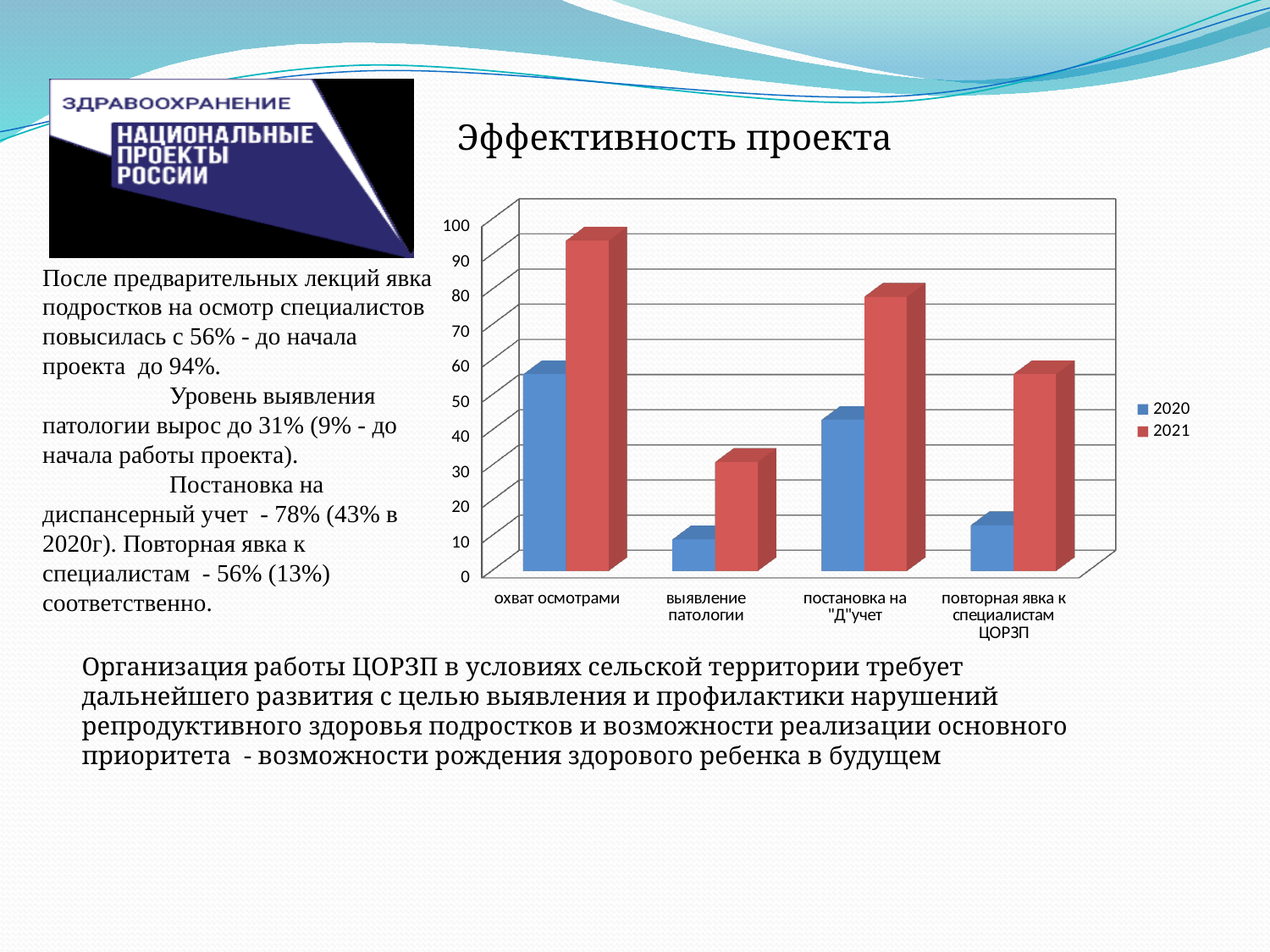
What type of chart is shown on the slide? bar chart How many categories are shown on the x axis of the chart? 4 Which category has the highest value for the 2021 series? охват осмотрами For 'постановка на "Д"учет', which series has the larger value, 2020 or 2021? 2021 Is the 2020 value for 'повторная явка к специалистам ЦОРЗП' greater or less than 20? less Is the 2021 value for 'охват осмотрами' greater or less than 90? greater Is the 2021 value for 'выявление патологии' greater or less than 20? greater What is the title of the chart? Эффективность проекта Which category has the lowest value for the 2021 series? выявление патологии How many series does the chart legend list? 2 Which category has the highest value for the 2020 series? охват осмотрами